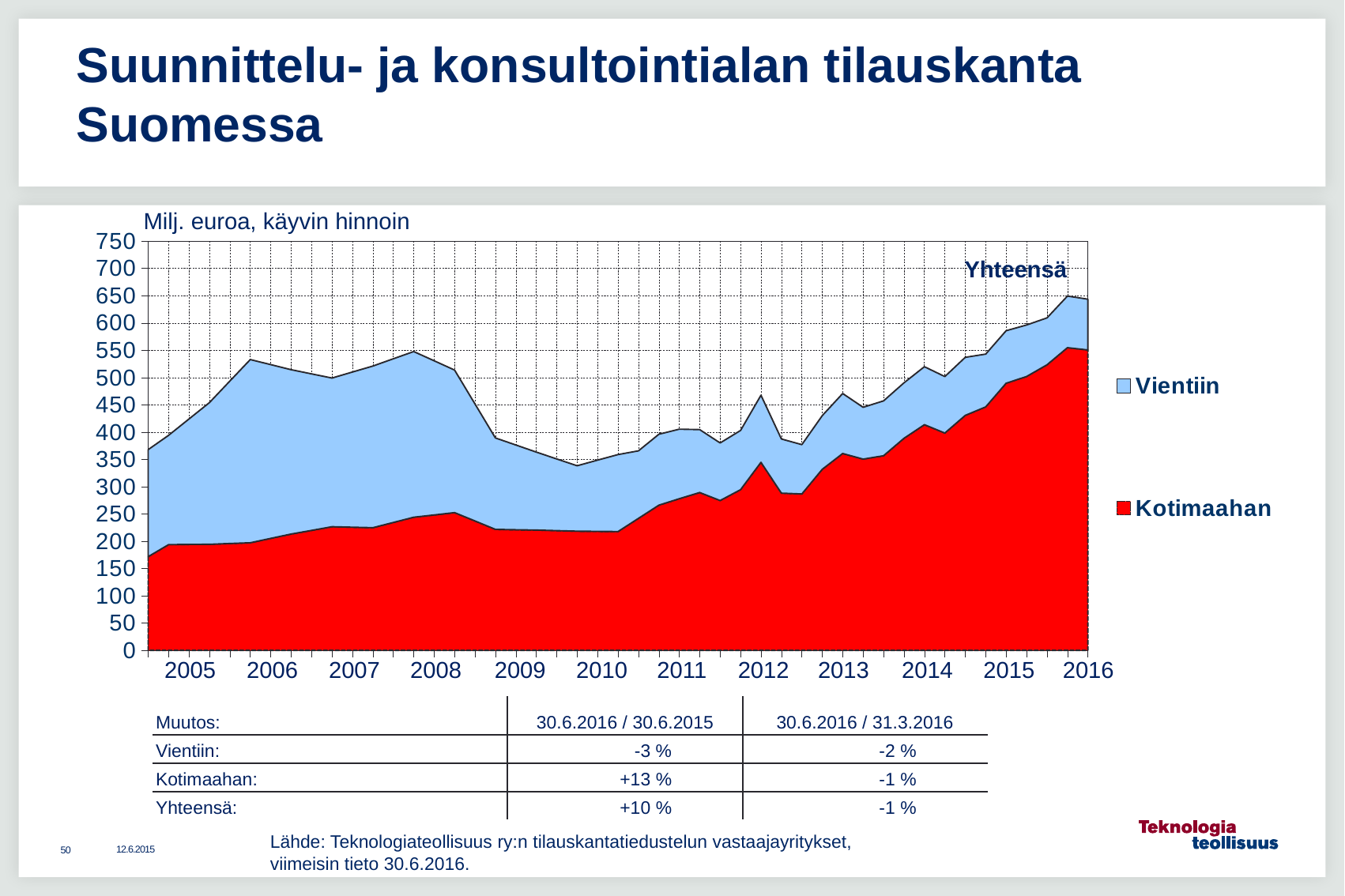
How many series does the legend list? 2 In which year is the total (Yhteensä) at its lowest level? 2010 What unit label is shown above the chart's vertical axis? Milj. euroa, käyvin hinnoin Is the Kotimaahan value at the start of 2005 greater or less than 200? less In which year does the total (Yhteensä) reach its highest level? 2016 What kind of chart is shown on the slide? Stacked area chart Which two series are listed in the chart legend? Vientiin and Kotimaahan How many years are labelled on the x axis? 12 Is the total (Yhteensä) value at 2016 greater or less than 600? greater Is the Kotimaahan value at 2010 greater or less than 250? less Does the Kotimaahan series rise or fall from 2010 to 2016? rise Is the Kotimaahan value larger at 2016 or at 2005? 2016